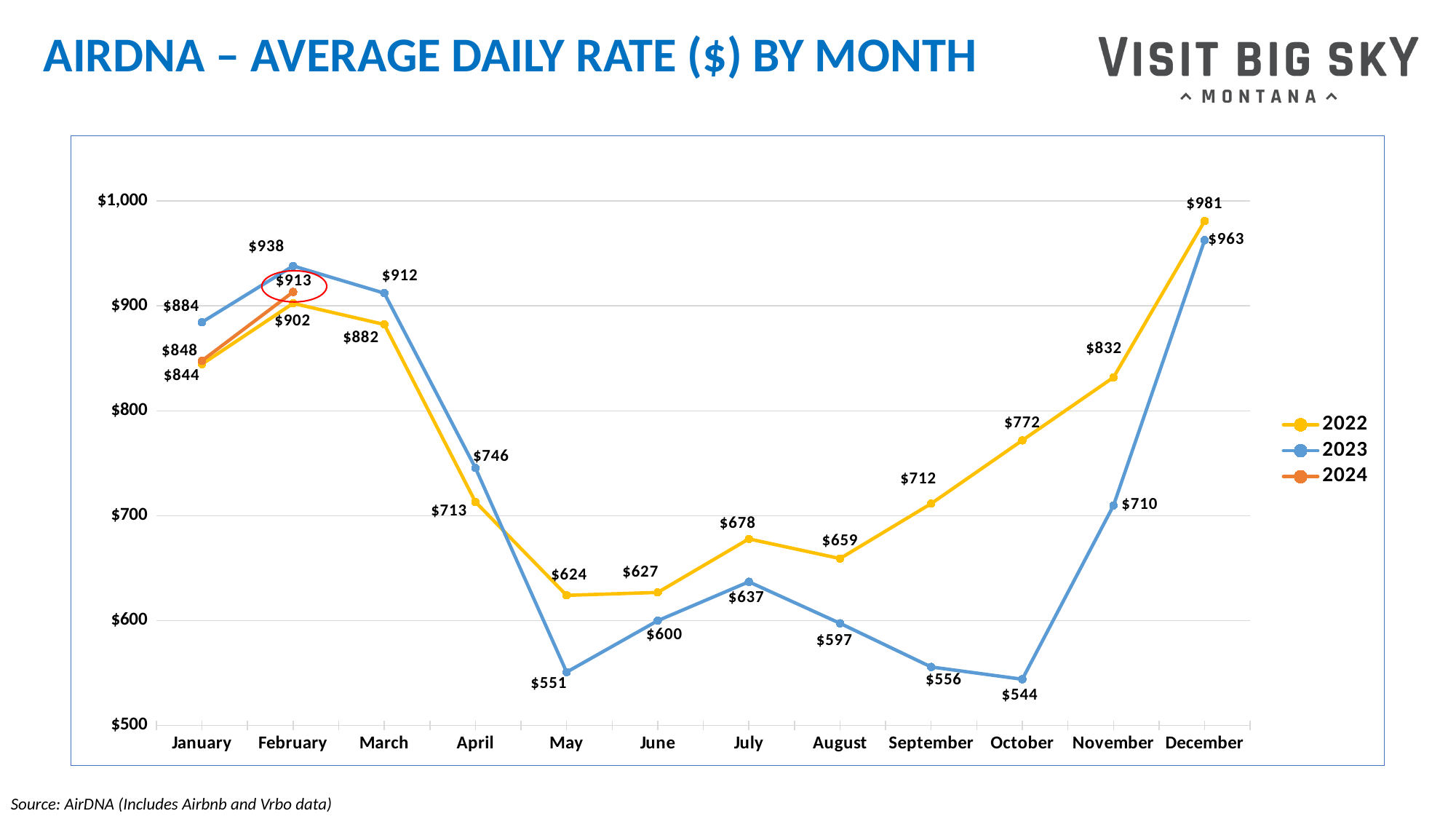
What is the difference between the December rates for 2022 and 2023? $18 In which month was the 2023 average daily rate lowest? October What was the average daily rate for 2022 in December? $981 How many months are plotted along the x axis? 12 Does the 2022 average daily rate rise or fall from May to December? Rise What was the average daily rate for 2023 in May? $551 In which month was the 2022 average daily rate lowest? May Which year had the higher average daily rate in April, 2022 or 2023? 2023 How many series does the legend list? 3 What kind of chart is shown on the slide? Line chart What was the average daily rate for 2024 in February? $913 In which month was the 2023 average daily rate highest? December